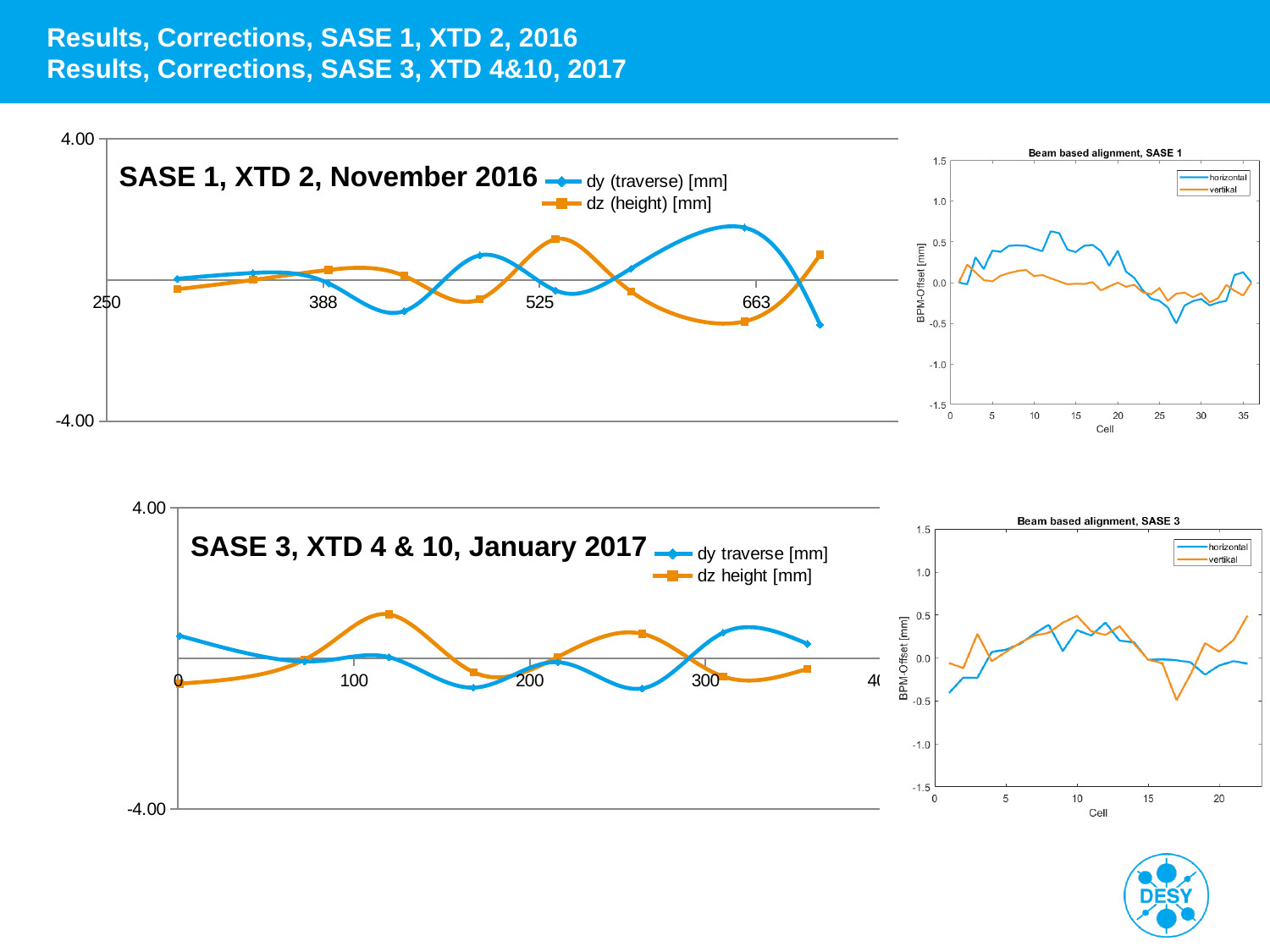
How many series does the legend of the 'Beam based alignment, SASE 3' chart list? 2 What are the two legend entries of the 'SASE 3, XTD 4 & 10, January 2017' chart? dy traverse [mm] and dz height [mm] How many series does the legend of the 'SASE 1, XTD 2, November 2016' chart list? 2 How many x-axis tick labels are shown on the 'SASE 1, XTD 2, November 2016' chart? 4 In the 'SASE 3, XTD 4 & 10, January 2017' chart, does the dz height series rise or fall from x = 0 to x = 100? rise In the 'Beam based alignment, SASE 1' chart, which series reaches the highest value? horizontal In the 'Beam based alignment, SASE 1' chart, is the horizontal value at cell 12 greater or less than 0.0? greater What kind of chart is the 'SASE 1, XTD 2, November 2016' chart? line chart In the 'Beam based alignment, SASE 1' chart, at cell 27, which series has the larger value, horizontal or vertikal? vertikal In the 'Beam based alignment, SASE 3' chart, does the vertikal series rise or fall from cell 17 to cell 22? rise In the 'Beam based alignment, SASE 1' chart, is the horizontal value at cell 27 greater or less than 0.0? less What is the y-axis label of the 'Beam based alignment, SASE 1' chart? BPM-Offset [mm]